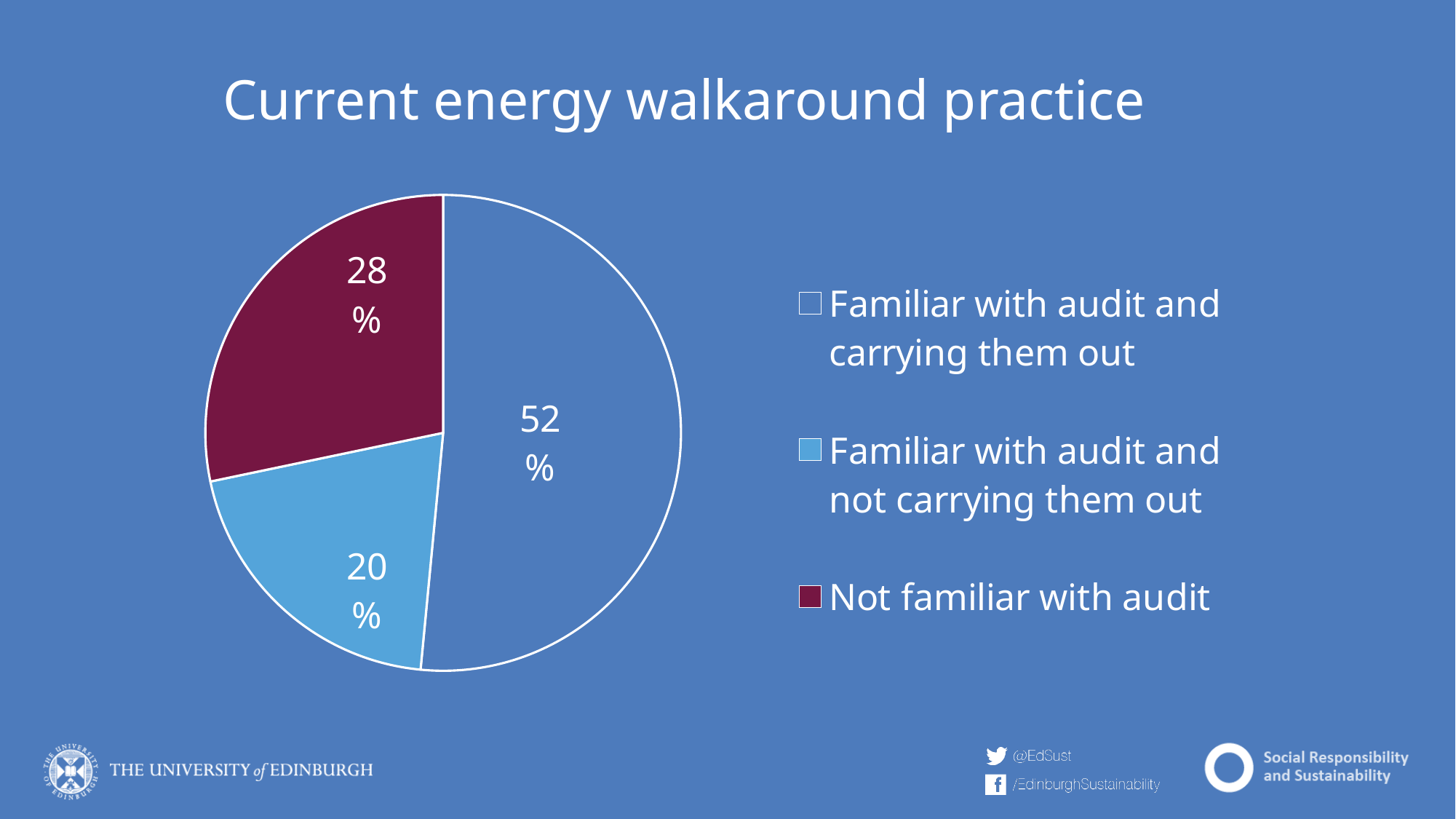
Which category has the smallest share of the pie? Familiar with audit and not carrying them out What percentage of respondents are familiar with audit and not carrying them out? 20% Which is larger: the share for 'Not familiar with audit' or the share for 'Familiar with audit and not carrying them out'? Not familiar with audit What is the difference in percentage points between 'Not familiar with audit' and 'Familiar with audit and not carrying them out'? 8 What type of chart is shown on the slide? Pie chart Which category has the largest share of the pie? Familiar with audit and carrying them out What is the title of the chart on the slide? Current energy walkaround practice What is the difference in percentage points between 'Familiar with audit and carrying them out' and 'Not familiar with audit'? 24 What percentage of respondents are not familiar with audit? 28% Which colour represents 'Not familiar with audit' in the pie chart? Dark red (maroon) How many slices does the pie chart have? 3 What percentage of respondents are familiar with audit and carrying them out? 52%